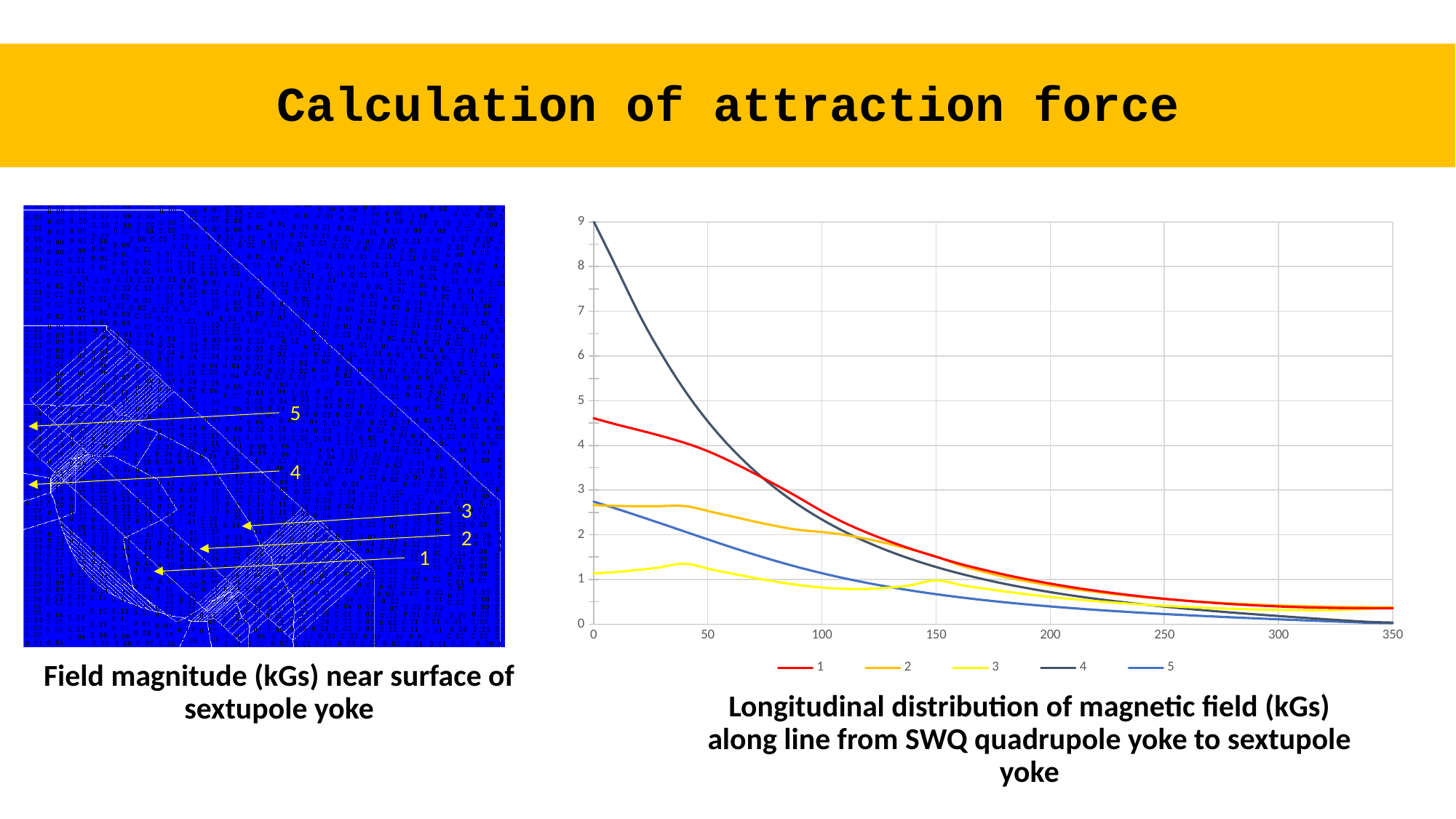
In the line chart, which series has the lowest value at x = 0? 3 What kind of chart is shown on the right of the slide? line chart What colour is series 1 in the line chart's legend? red In the line chart, does series 4 rise or fall as x increases from 0 to 350? fall In the line chart, is the value of series 3 at x = 0 greater or less than 2? less In the line chart, is the value of series 1 at x = 0 greater or less than 4? greater In the line chart, is the value of series 1 at x = 350 greater or less than 1? less In the line chart, at x = 0, which series has the larger value: series 1 or series 4? 4 In the line chart, which series has the highest value at x = 0? 4 In the line chart, at x = 0, which series has the larger value: series 3 or series 5? 5 How many series does the legend of the line chart list? 5